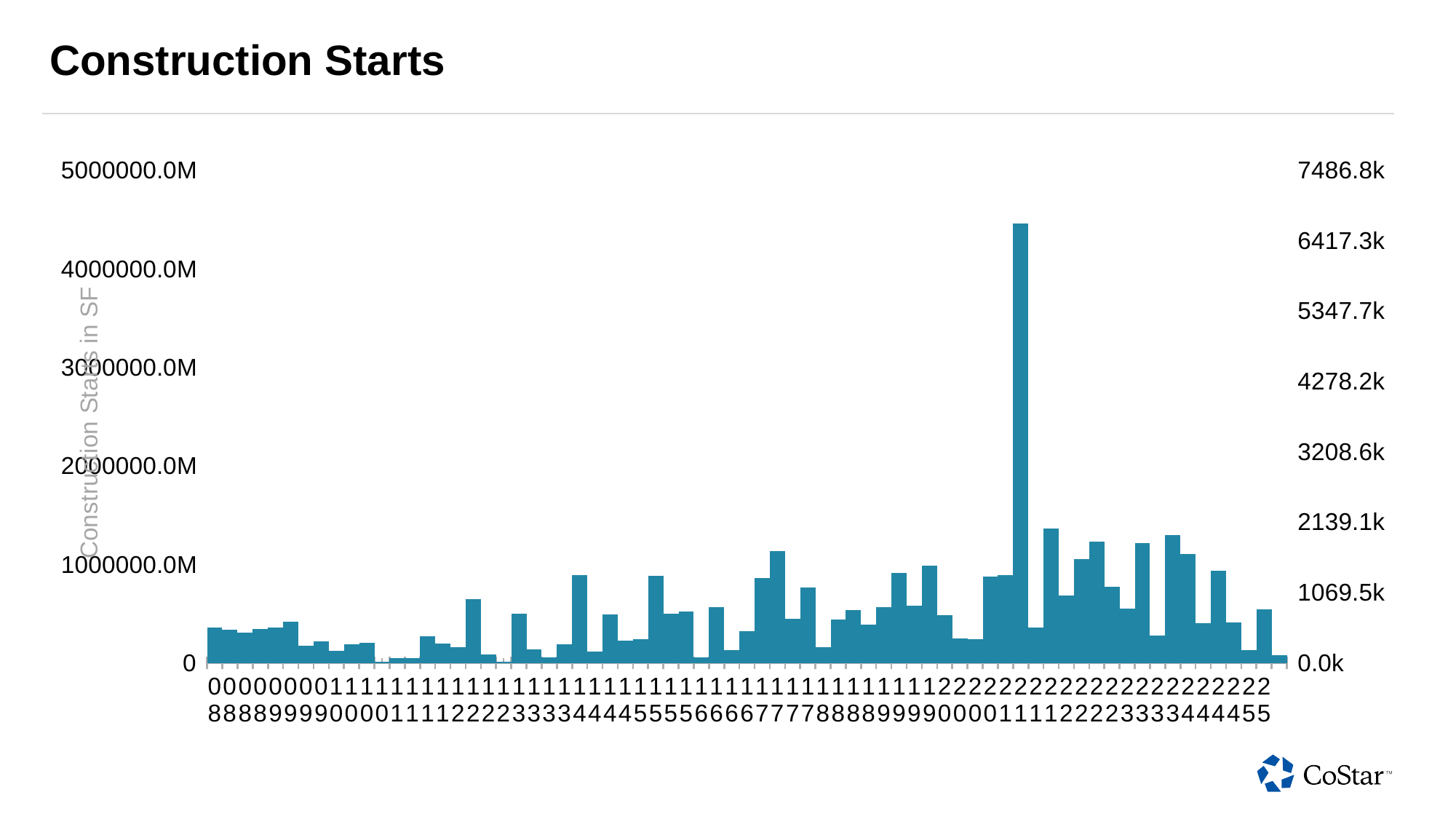
Is the second-tallest bar in the chart greater or less than 2000000.0M? less Is the value of the tallest bar greater or less than 5000000.0M on the left axis? less Is the tallest bar under the 10 label greater or less than 1000000.0M? less What is the title of the chart? Construction Starts Which is larger: the tallest bar under the 21 label or the tallest bar under the 08 label? the bar under 21 What is the label on the left vertical axis of the chart? Construction Starts in SF Under which x-axis year label does the tallest bar appear? 21 Overall, do the bar values tend to rise or fall from left to right across the x axis? rise What kind of chart is shown on the slide? bar chart